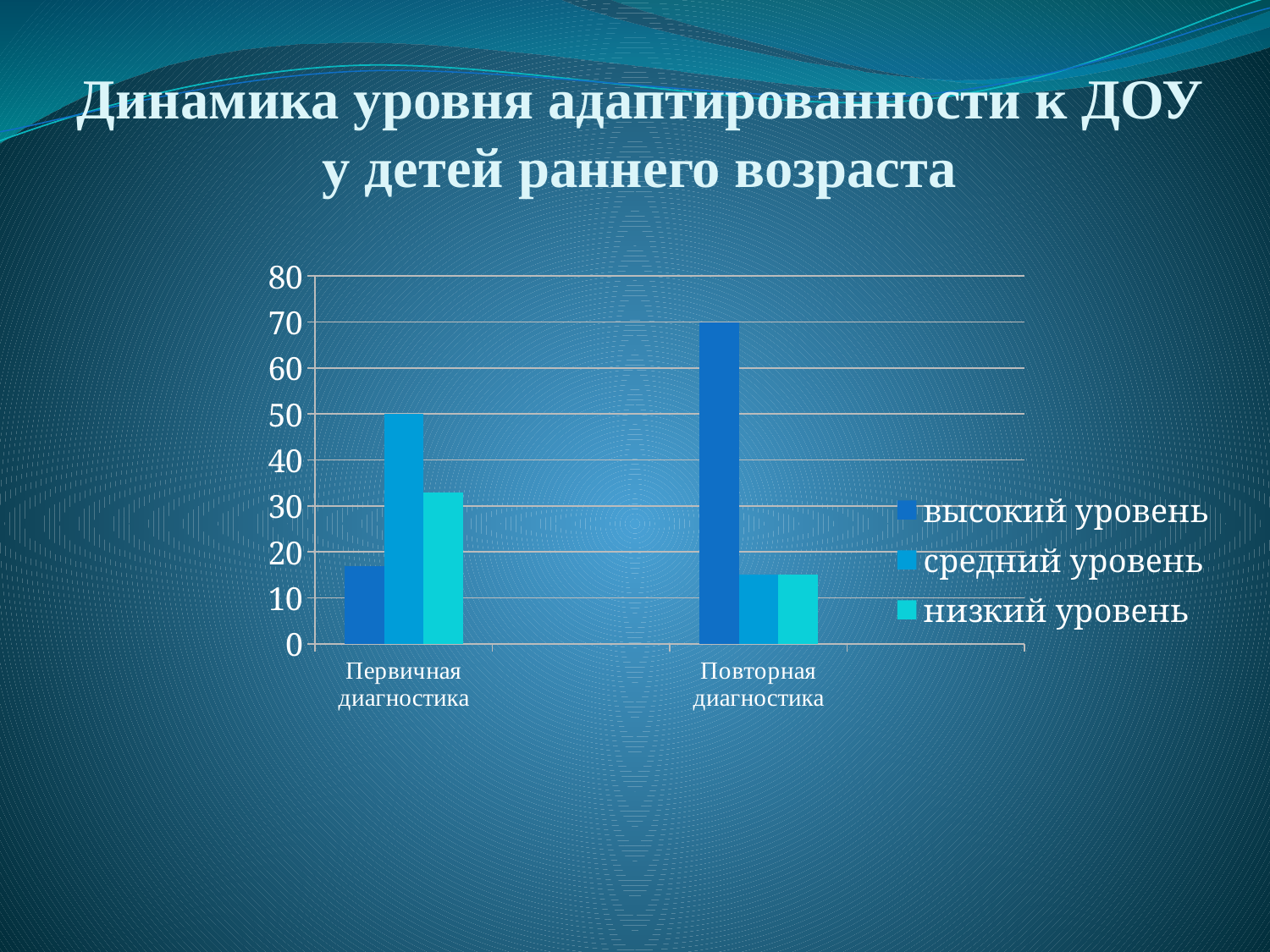
Is the value for высокий уровень at Первичная диагностика greater or less than 20? less What is the value for высокий уровень at Повторная диагностика? 70 Is the value for низкий уровень at Первичная диагностика greater or less than 30? greater Which series has the lowest value at Первичная диагностика? высокий уровень What is the title of the chart on the slide? Динамика уровня адаптированности к ДОУ у детей раннего возраста How many series does the chart's legend list? 3 Which series has the highest value at Повторная диагностика? высокий уровень What is the value for средний уровень at Первичная диагностика? 50 What kind of chart is shown on the slide? bar chart Which series has the highest value at Первичная диагностика? средний уровень Which category has the larger value for высокий уровень: Первичная диагностика or Повторная диагностика? Повторная диагностика How many categories are shown on the x axis of the chart? 2